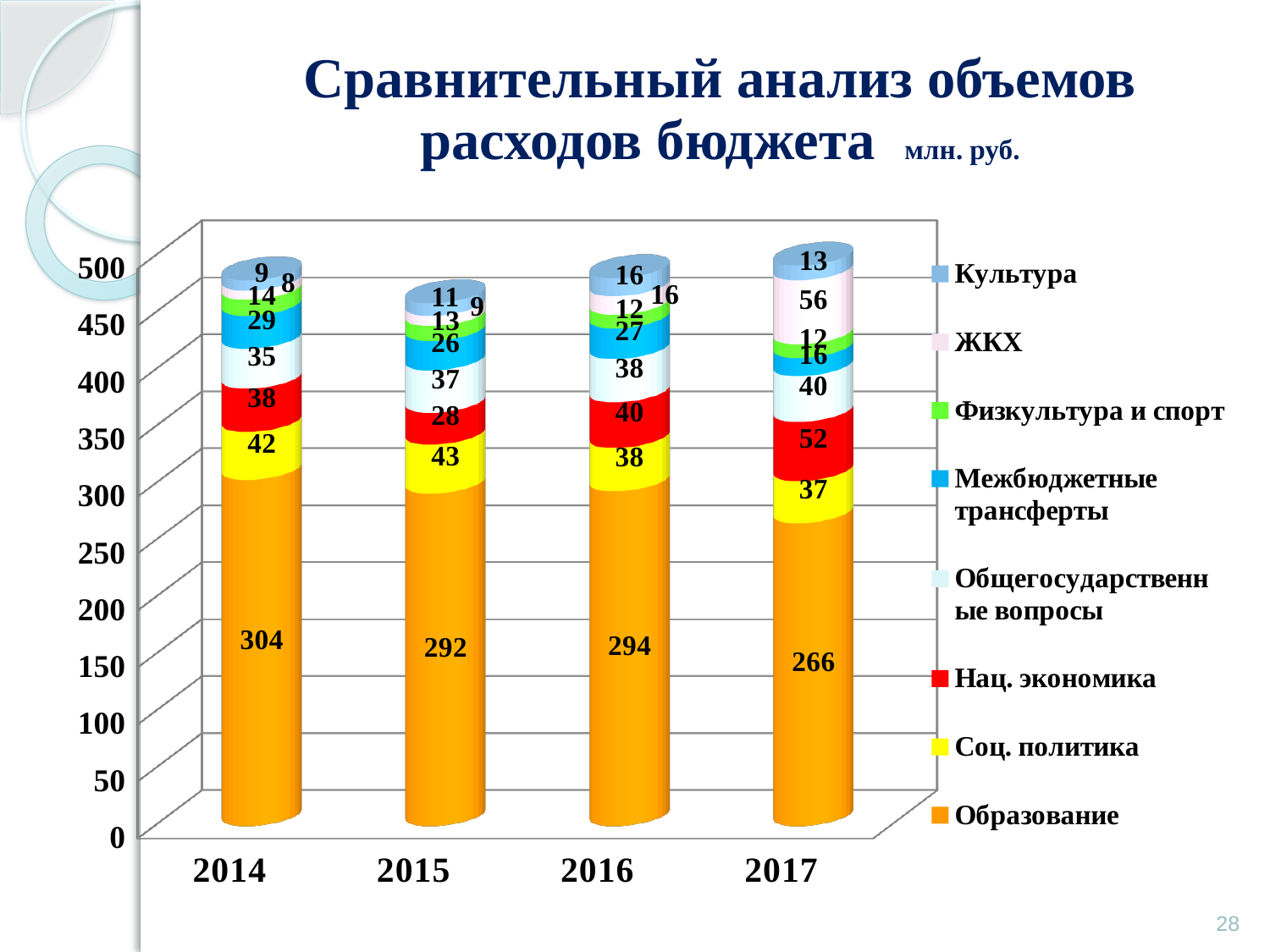
What is the difference between the Образование values for 2014 and 2017? 38 In which year is the Образование value the lowest? 2017 What kind of chart is shown on the slide? Stacked bar chart How many years are shown on the x axis? 4 Which year has the larger Соц. политика value, 2015 or 2016? 2015 In which year is the Образование value the highest? 2014 What is the value for Образование in 2014? 304 What is the value for Нац. экономика in 2017? 52 How many series does the legend list? 8 What is the total of the stacked bar for 2014? 479 Do the values for Общегосударственные вопросы rise or fall from 2014 to 2017? Rise What is the value for Общегосударственные вопросы in 2016? 38